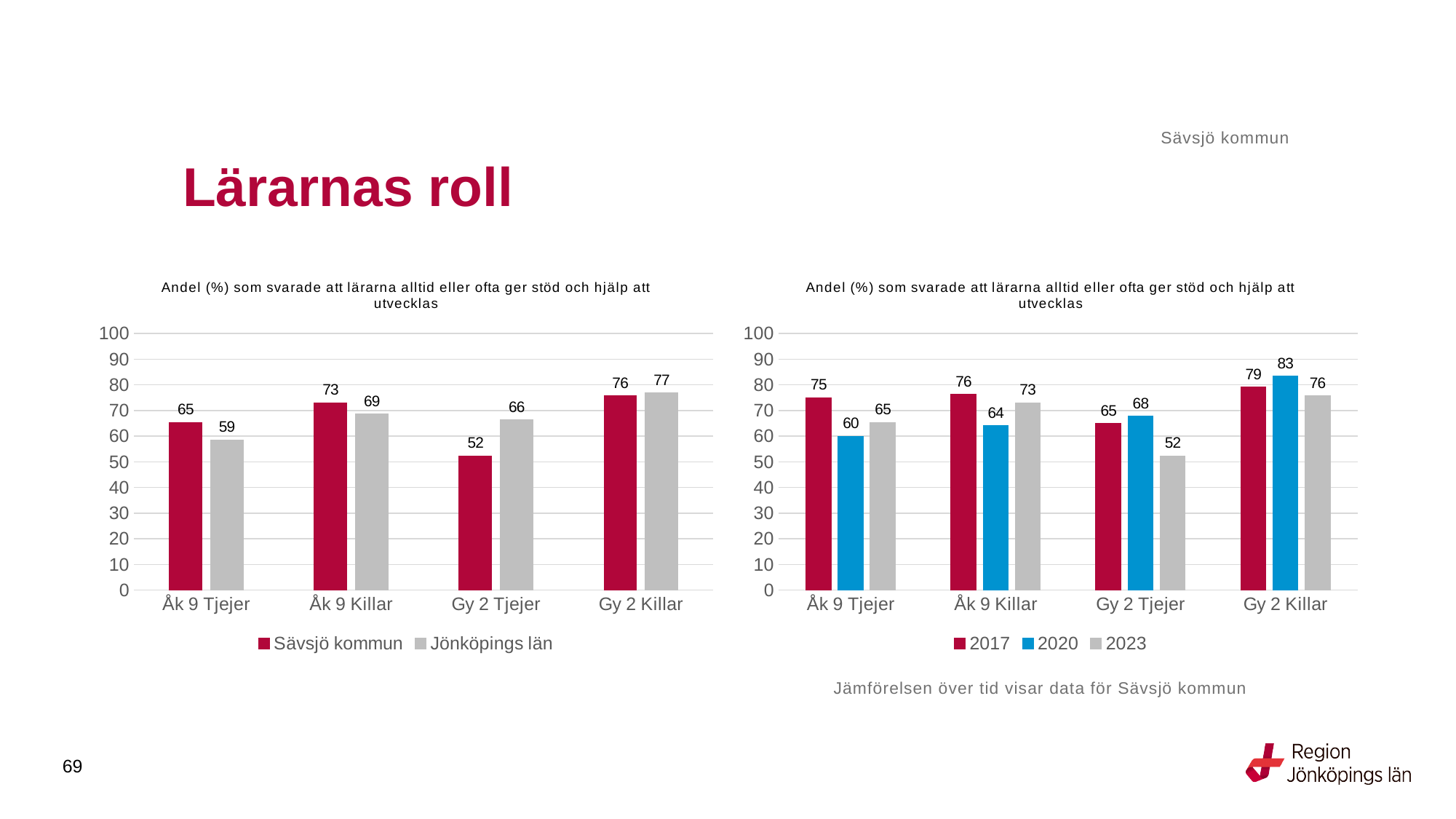
In the left chart, which category has the lowest value for Sävsjö kommun? Gy 2 Tjejer In the left chart, what is the difference between Jönköpings län and Sävsjö kommun for Gy 2 Tjejer? 14 In the right chart, how many categories are shown on the x axis? 4 In the left chart, what is the value for Sävsjö kommun for Gy 2 Tjejer? 52 In the right chart, what is the value for 2023 for Åk 9 Tjejer? 65 In the left chart, how many series does the legend list? 2 In the right chart, what is the difference between the 2017 and 2023 values for Gy 2 Tjejer? 13 In the left chart, what is the value for Jönköpings län for Åk 9 Killar? 69 In the right chart, which is larger for Åk 9 Killar: the 2017 value or the 2020 value? 2017 In the right chart, what is the value for 2020 for Gy 2 Killar? 83 In the right chart, which category has the highest value for 2017? Gy 2 Killar What type of chart is the right chart? Bar chart